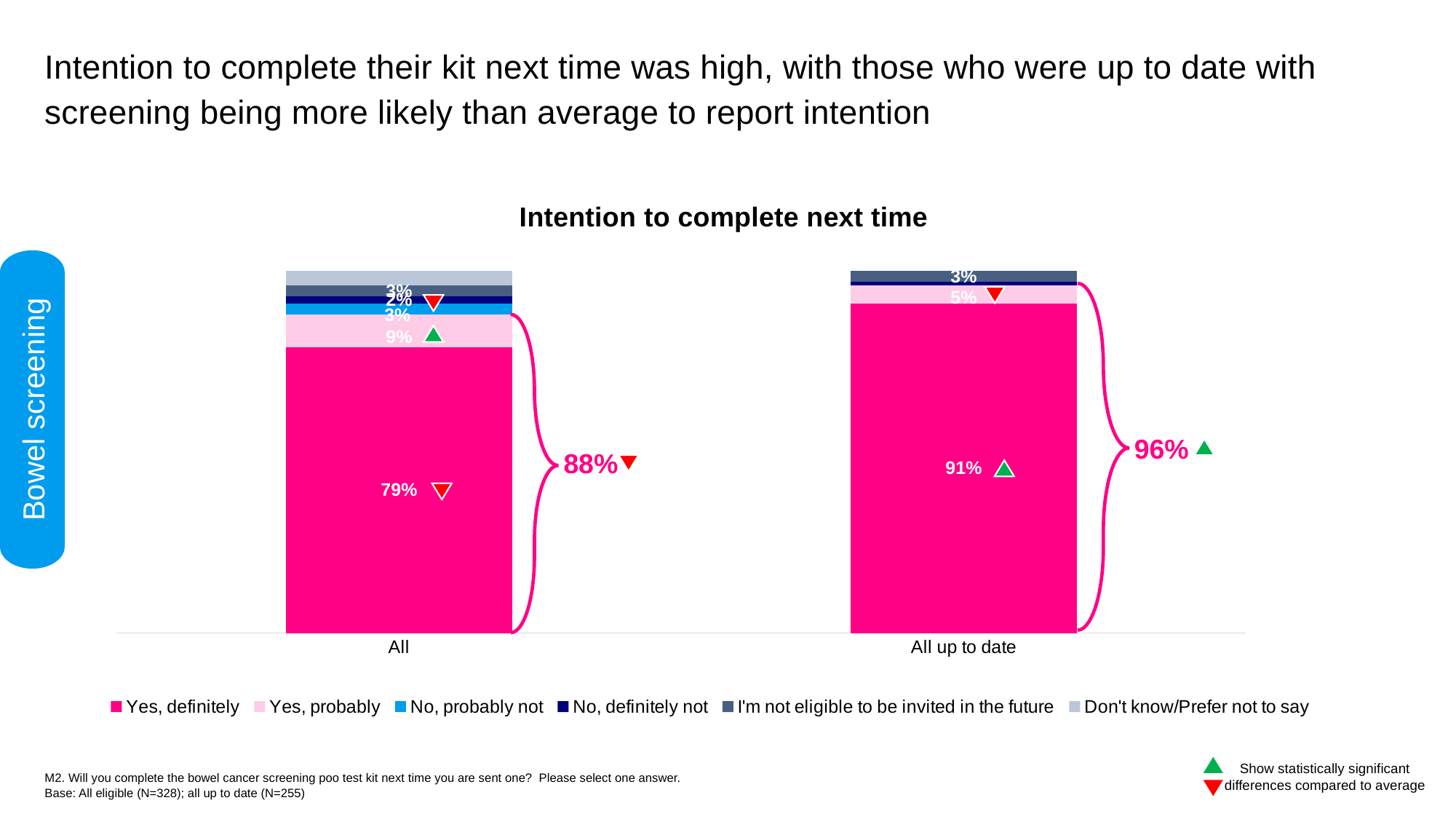
What combined intention percentage is shown by the brace next to the 'All' bar? 88% What is the 'Yes, definitely' value for the 'All up to date' bar? 91% What kind of chart is shown on the slide? Stacked bar chart Which category has the larger 'Yes, definitely' value, 'All' or 'All up to date'? All up to date What is the 'Yes, probably' value for the 'All up to date' bar? 5% How many series does the chart legend list? 6 What is the 'Yes, probably' value for the 'All' bar? 9% What is the 'Yes, definitely' value for the 'All' bar? 79% What is the title of the chart? Intention to complete next time What combined intention percentage is shown by the brace next to the 'All up to date' bar? 96% What is the difference in the 'Yes, definitely' value between 'All up to date' and 'All'? 12 percentage points How many categories are shown on the x axis of the chart? 2